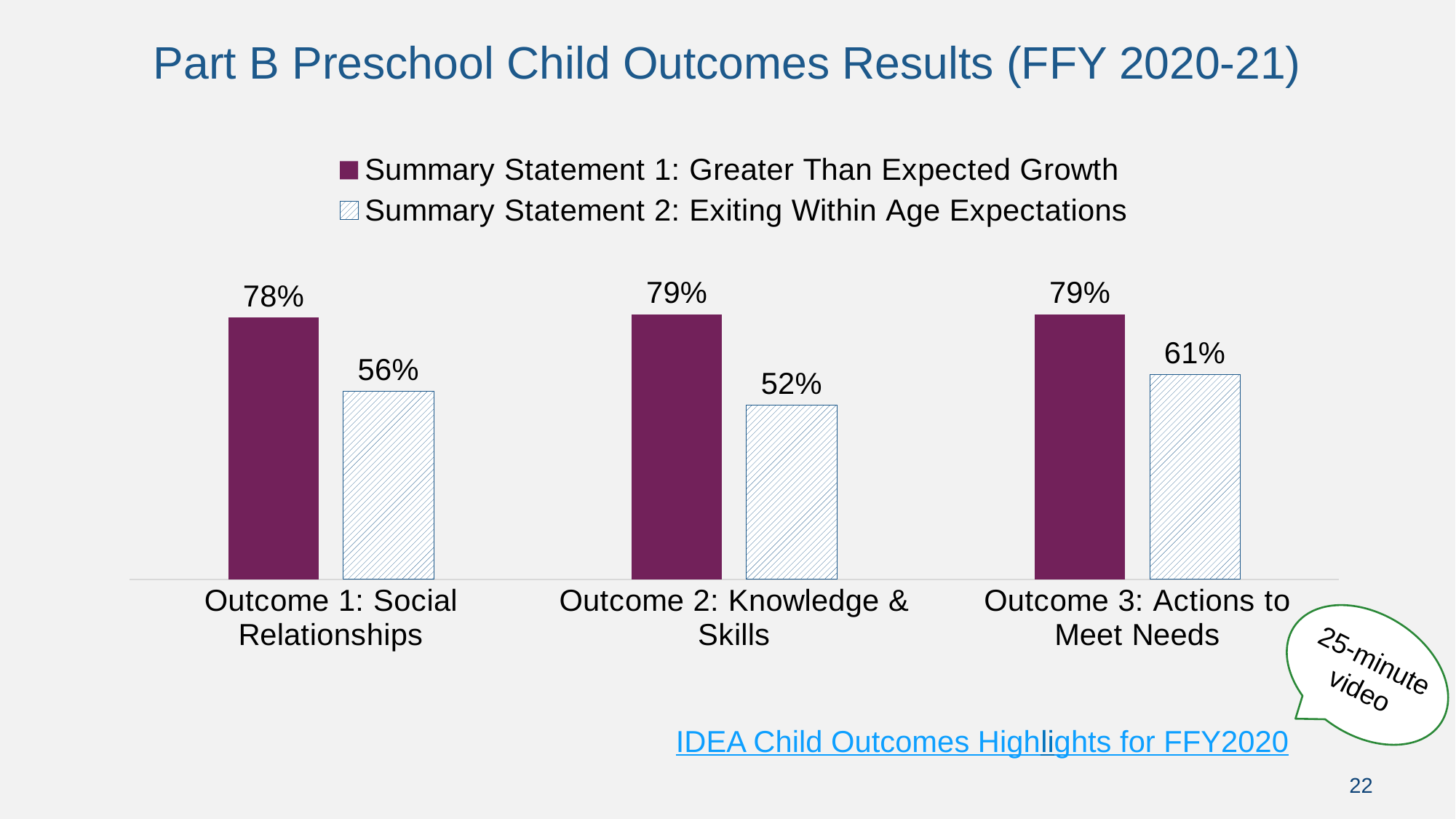
What is the difference between the Summary Statement 1 and Summary Statement 2 values for Outcome 1: Social Relationships? 22% How many outcome categories are shown on the chart? 3 How many series does the legend list? 2 Which outcome has the lowest Summary Statement 2: Exiting Within Age Expectations value? Outcome 2: Knowledge & Skills Which outcome has the highest Summary Statement 2: Exiting Within Age Expectations value? Outcome 3: Actions to Meet Needs What kind of chart is shown on the slide? Bar chart What is the difference between the Summary Statement 2 values for Outcome 3: Actions to Meet Needs and Outcome 2: Knowledge & Skills? 9% Which is larger for Outcome 3: Actions to Meet Needs, the Summary Statement 1 value or the Summary Statement 2 value? Summary Statement 1 What is the Summary Statement 2: Exiting Within Age Expectations value for Outcome 3: Actions to Meet Needs? 61% What is the Summary Statement 2: Exiting Within Age Expectations value for Outcome 2: Knowledge & Skills? 52% What is the Summary Statement 1: Greater Than Expected Growth value for Outcome 1: Social Relationships? 78% What is the Summary Statement 1: Greater Than Expected Growth value for Outcome 2: Knowledge & Skills? 79%